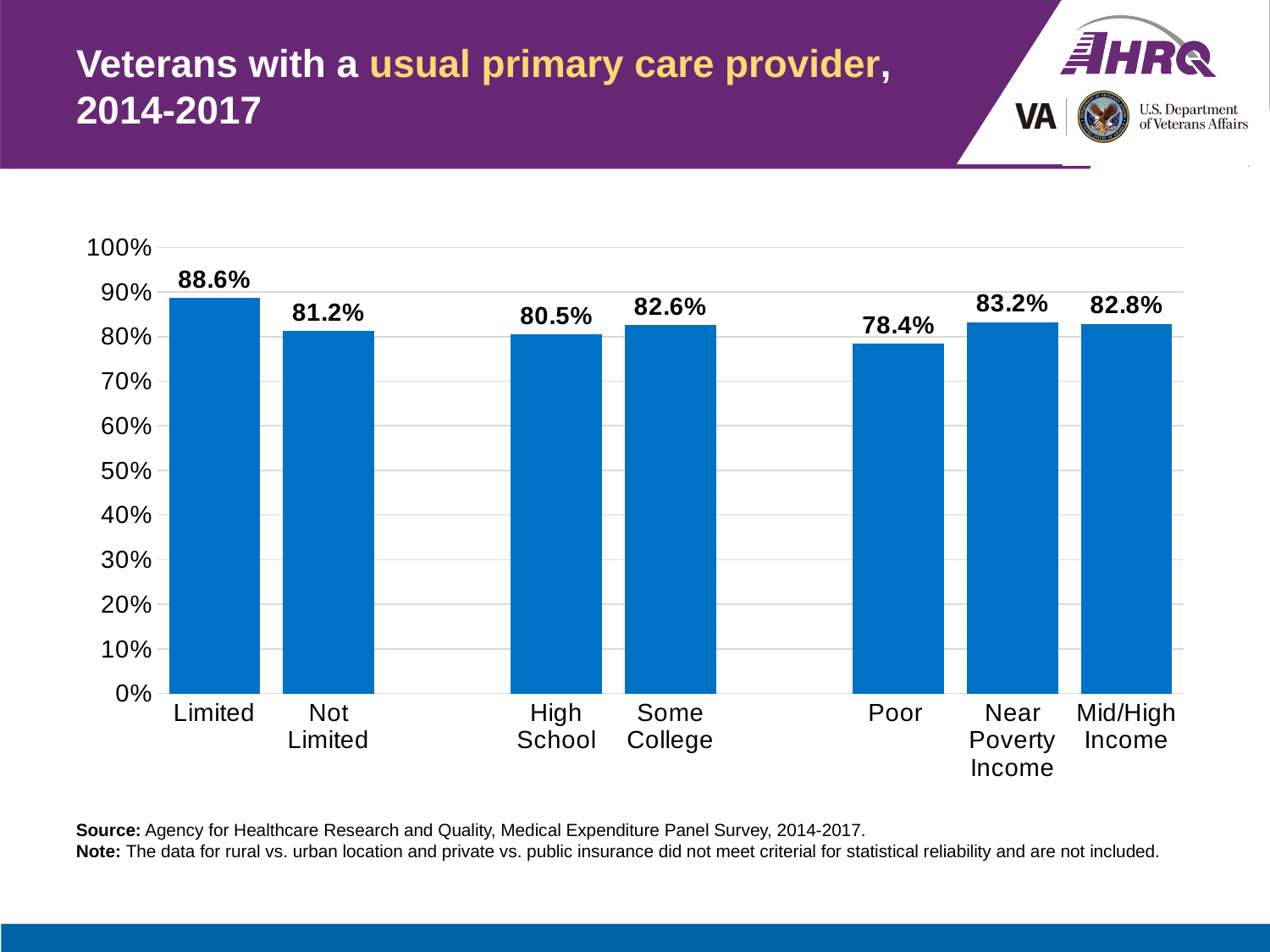
Is the value for High School greater or less than 90%? less Which category has the lowest value? Poor What is the difference between the values for Limited and Not Limited? 7.4% What is the value for Some College? 82.6% What kind of chart is shown on the slide? bar chart What is the difference between the values for Some College and High School? 2.1% Which category has the highest value? Limited Which is larger, the value for Mid/High Income or the value for Poor? Mid/High Income What is the value for Near Poverty Income? 83.2% What is the value for Limited? 88.6% What is the value for Poor? 78.4% How many categories are shown in the chart? 7